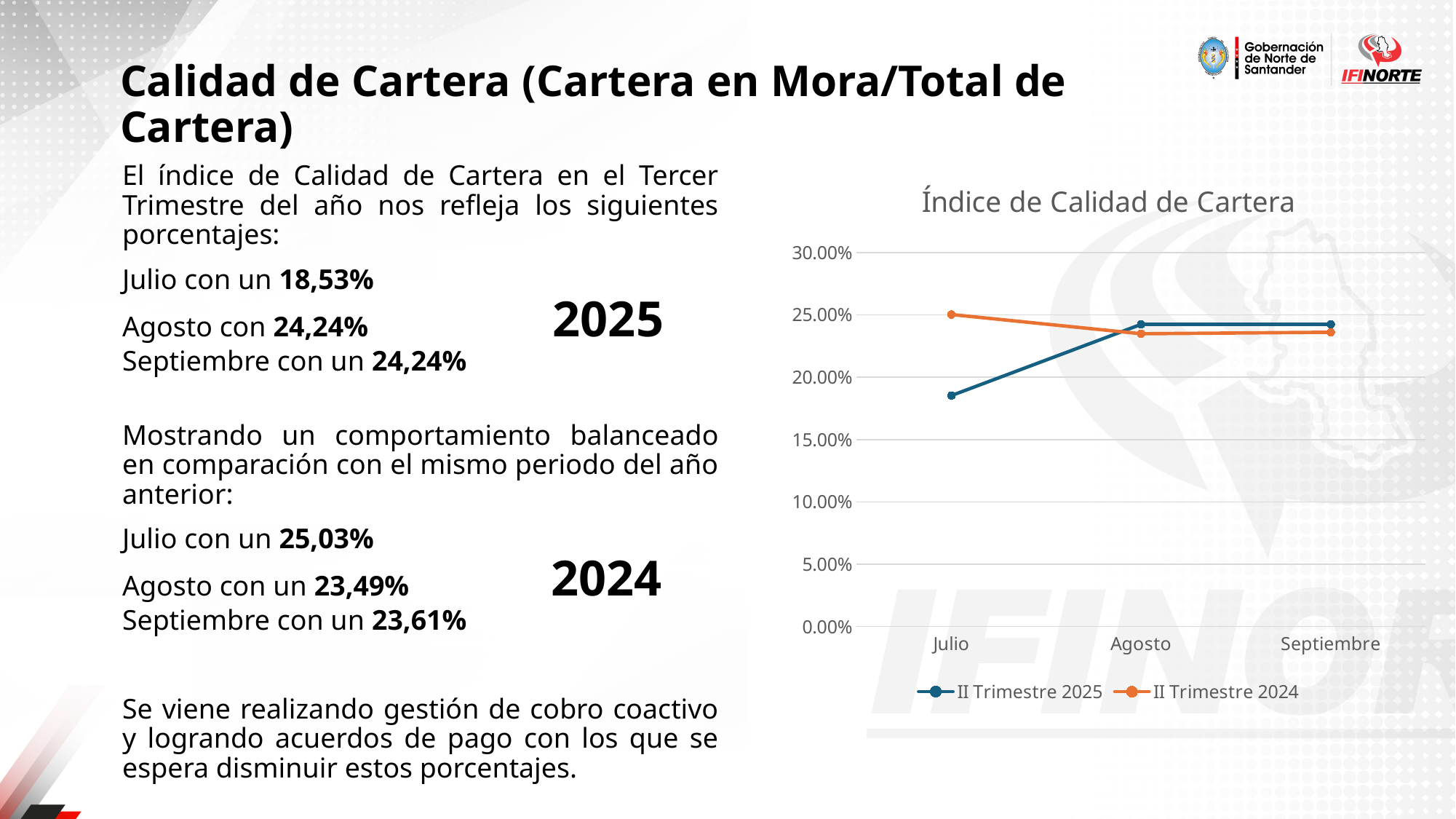
What kind of chart is shown on the slide? line chart Which colour is used for the II Trimestre 2024 series in the chart? orange Does the II Trimestre 2025 series rise or fall from Julio to Agosto? rise How many months are plotted along the x axis of the chart? 3 In Julio, which series has the higher value, II Trimestre 2025 or II Trimestre 2024? II Trimestre 2024 Is the value for II Trimestre 2025 in Julio greater or less than 20.00%? less What is the title of the chart? Índice de Calidad de Cartera In which month is the II Trimestre 2025 series at its lowest? Julio Is the value for II Trimestre 2024 in Julio greater or less than 20.00%? greater Is the value for II Trimestre 2025 in Septiembre greater or less than 25.00%? less How many series does the legend of the chart list? 2 In Agosto, which series has the higher value, II Trimestre 2025 or II Trimestre 2024? II Trimestre 2025